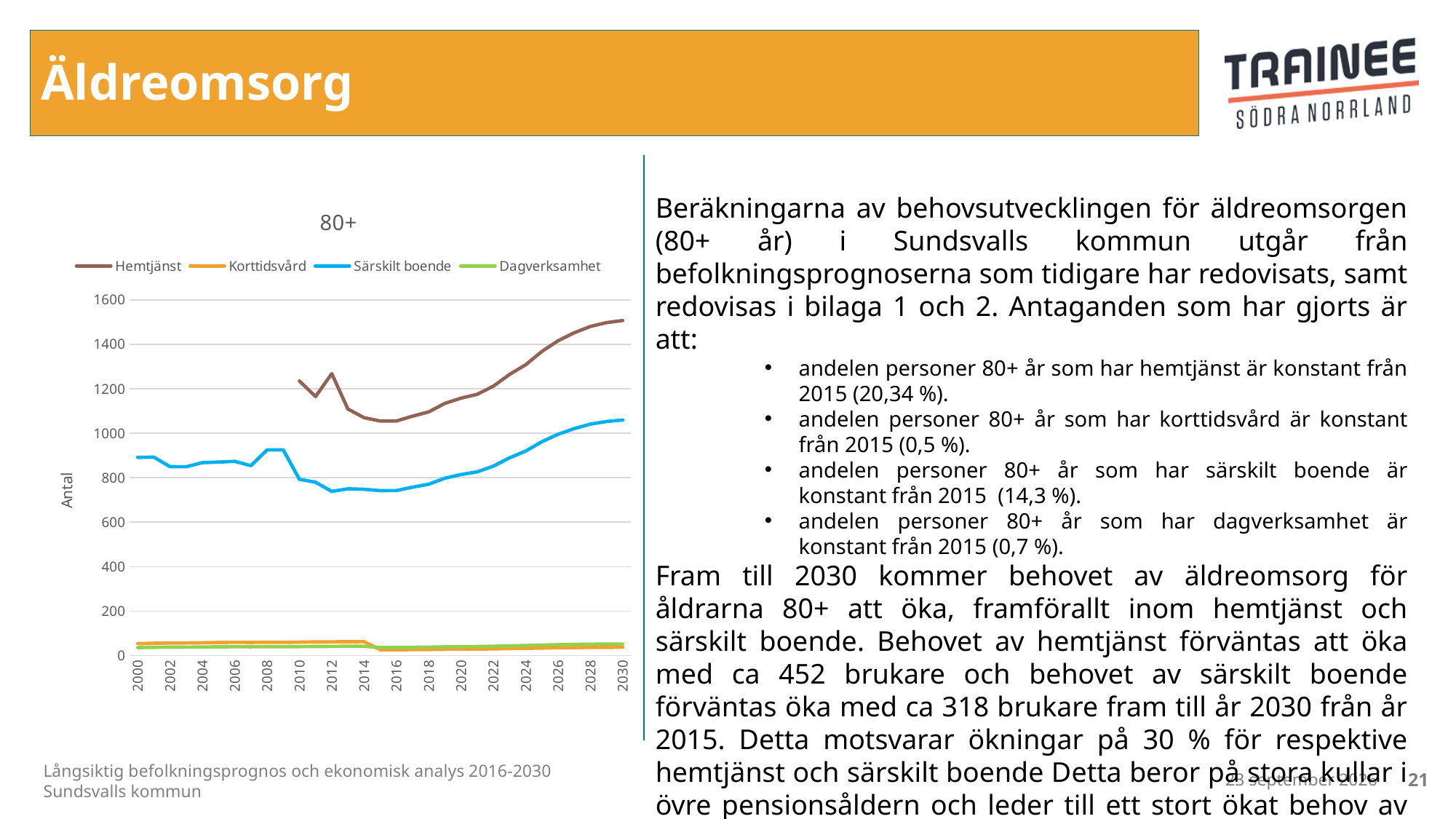
In 2030, which is larger: Hemtjänst or Särskilt boende? Hemtjänst Is the value for Hemtjänst in 2016 greater or less than 1200? less What kind of chart is shown on the slide? line chart Is the value for Hemtjänst in 2030 greater or less than 1400? greater How many series does the chart legend list? 4 Which series has the highest value in 2030? Hemtjänst How many year labels are shown on the x axis? 16 What is the title of the chart? 80+ What is the label on the vertical axis of the chart? Antal Is the value for Särskilt boende in 2016 greater or less than 800? less Does the Särskilt boende line rise or fall between 2016 and 2030? rises